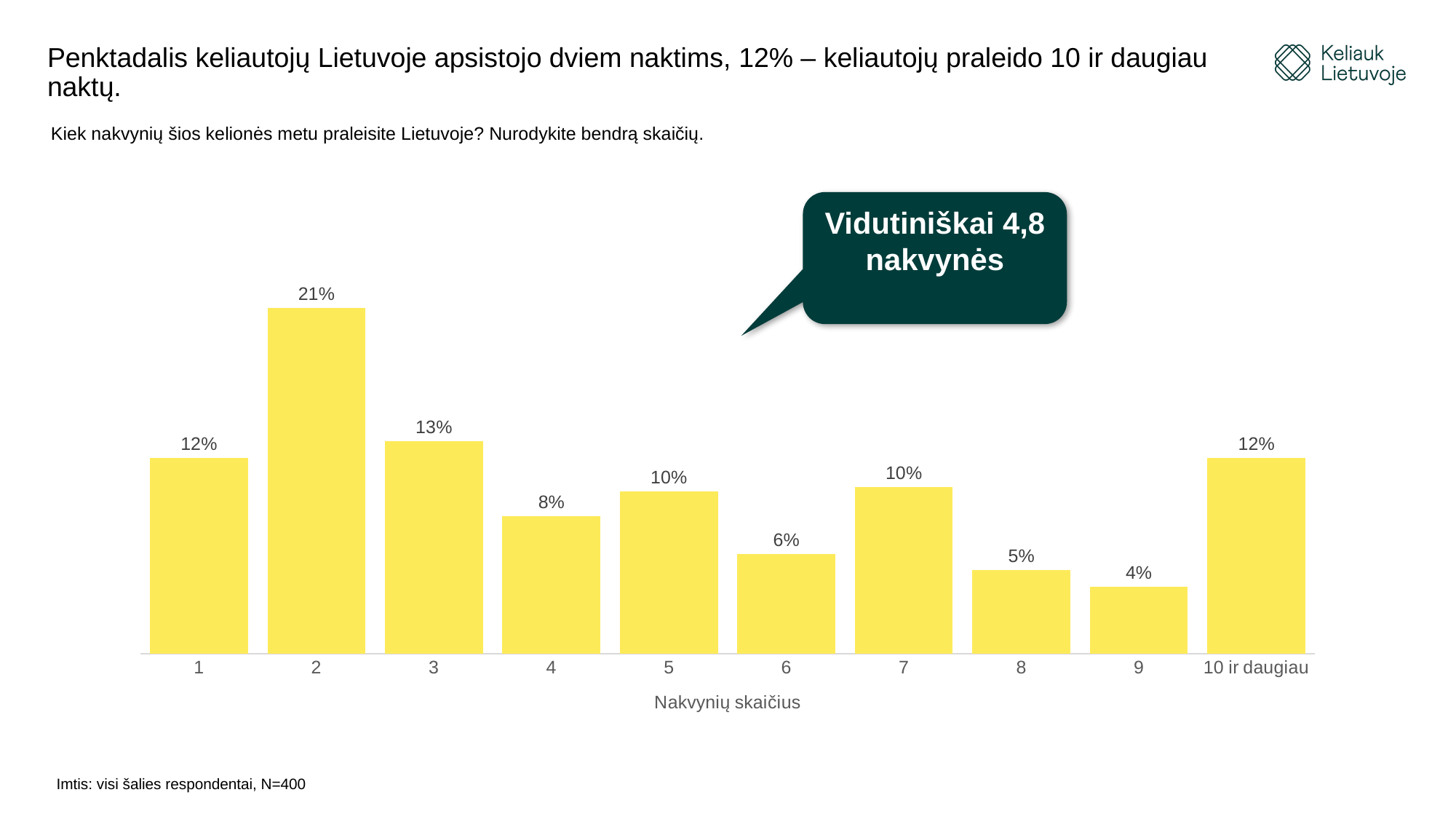
What is the difference between the values for 2 nights and 3 nights? 8% Which number of nights has the highest share of travellers? 2 What percentage is shown for the '10 ir daugiau' category? 12% What kind of chart is shown on the slide? Bar chart What is the value shown for 4 nights? 8% Do the values rise or fall from 2 nights to 6 nights? Fall Which is larger, the value for 5 nights or the value for 6 nights? 5 nights Which number of nights has the lowest share of travellers? 9 What average number of nights is stated in the callout on the chart? 4,8 nakvynės How many categories are shown on the x axis? 10 What percentage of travellers stayed 2 nights? 21% What is the x-axis title of the chart? Nakvynių skaičius